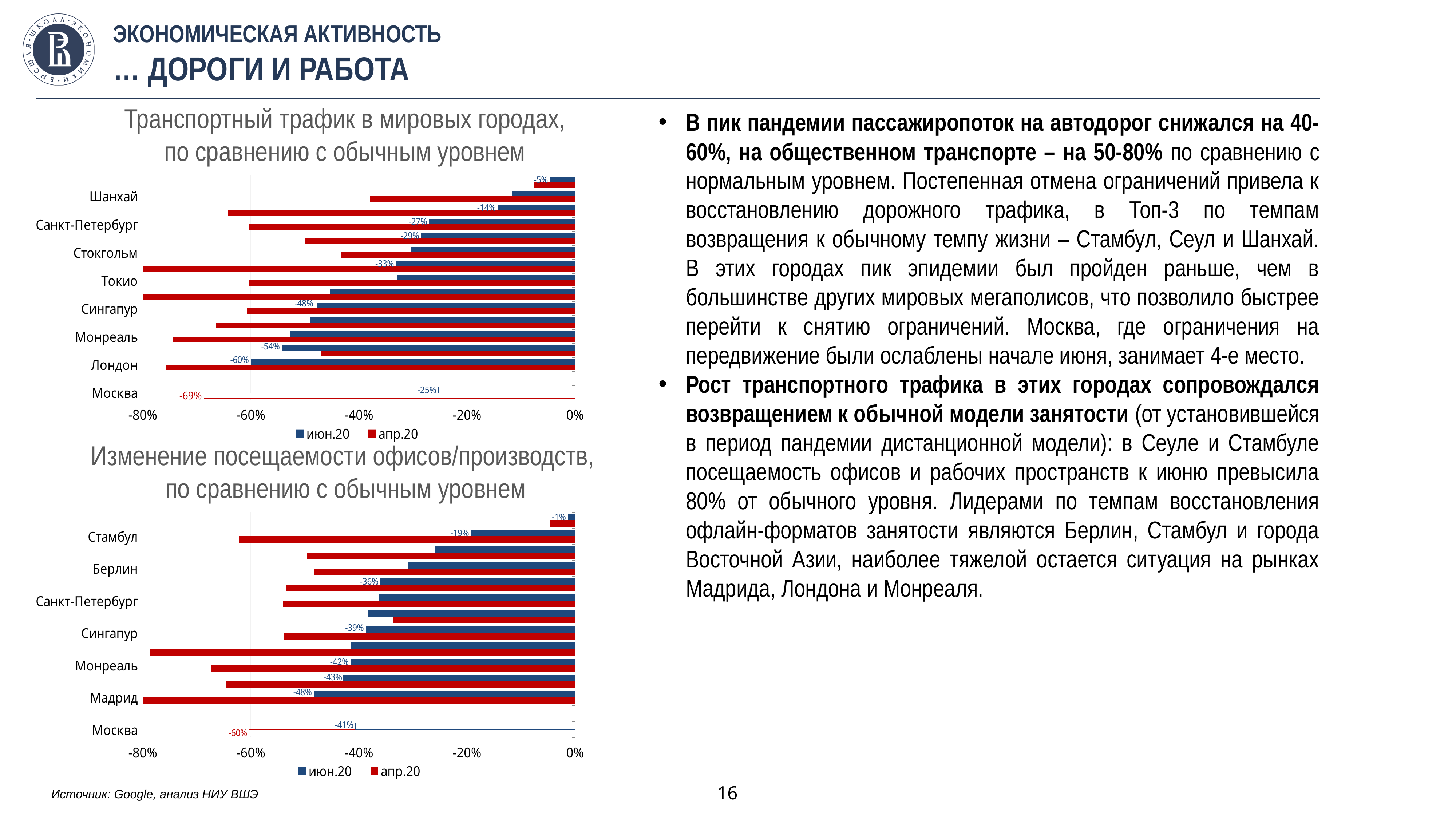
What kind of chart is the bottom chart, 'Изменение посещаемости офисов/производств'? bar chart In the bottom chart 'Изменение посещаемости офисов/производств', what is the value for Мадрид in июн.20? -48% In the top chart 'Транспортный трафик в мировых городах', by how many percentage points did Москва's value change from апр.20 (-69%) to июн.20 (-25%)? 44 percentage points In the bottom chart 'Изменение посещаемости офисов/производств', is the value for Мадрид in апр.20 greater or less than -60%? less In the bottom chart 'Изменение посещаемости офисов/производств', what is the value for Москва in апр.20? -60% In the top chart 'Транспортный трафик в мировых городах', what is the value for Москва in апр.20? -69% In the top chart 'Транспортный трафик в мировых городах', what is the value for Москва in июн.20? -25% In the bottom chart 'Изменение посещаемости офисов/производств', which has the smaller decline in июн.20: Стамбул or Мадрид? Стамбул How many series does the legend of the top chart 'Транспортный трафик в мировых городах' list? 2 In the bottom chart 'Изменение посещаемости офисов/производств', what is the value for Москва in июн.20? -41% In the top chart 'Транспортный трафик в мировых городах', what is the value for Лондон in июн.20? -60% In the bottom chart 'Изменение посещаемости офисов/производств', what is the value for Стамбул in июн.20? -19%